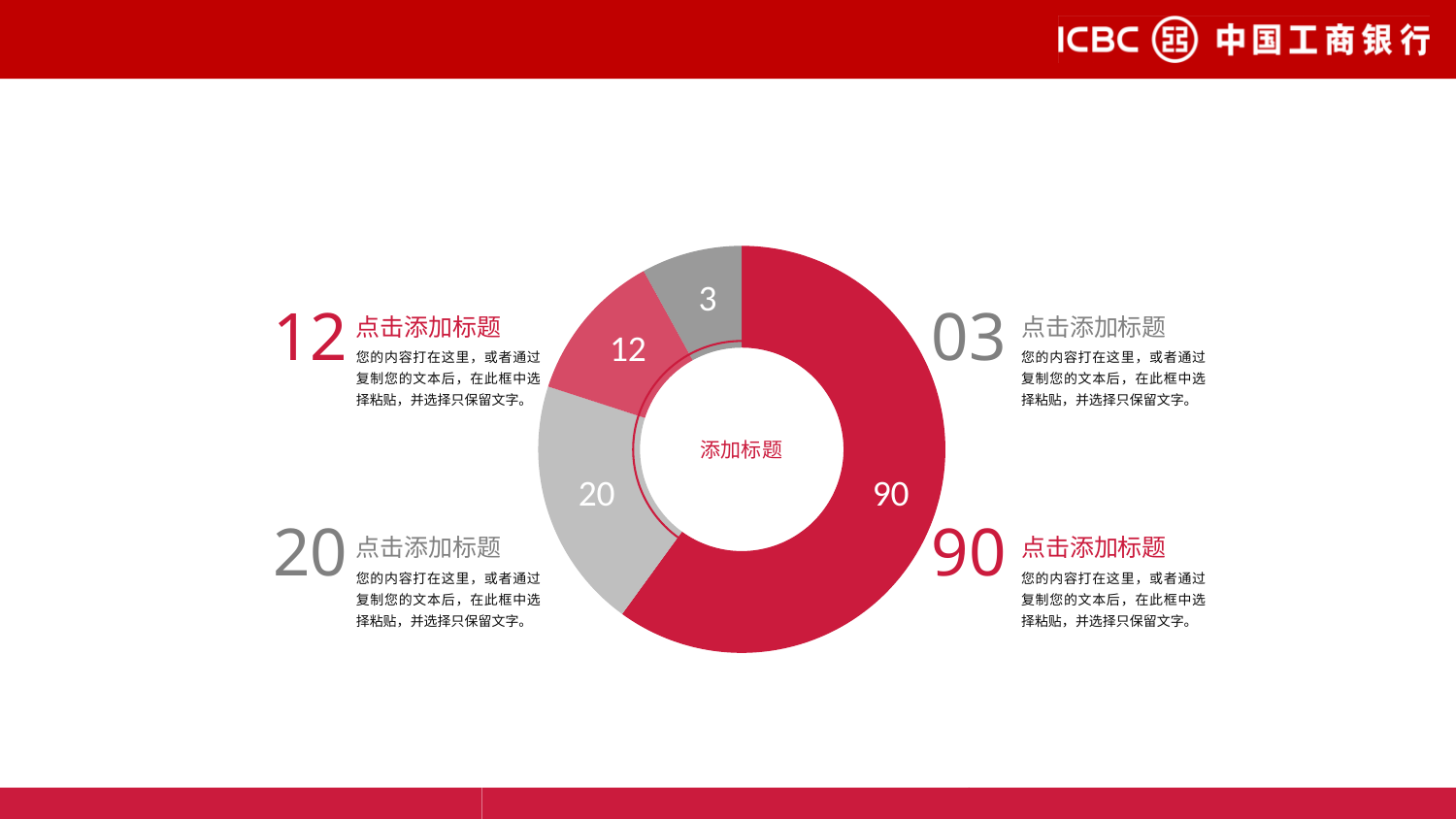
What is the value of the largest slice in the donut chart? 90 What text is written in the centre of the donut chart? 添加标题 What kind of chart is shown on the slide? pie chart (donut) What value is shown on the pink slice at the upper left of the donut chart? 12 What is the difference between the largest slice (90) and the light gray slice (20)? 70 What is the difference between the slice labelled 12 and the slice labelled 3? 9 What value is shown on the light gray slice at the left of the donut chart? 20 What is the value of the smallest slice in the donut chart? 3 How many slices does the donut chart have? 4 Which is larger, the light gray slice or the pink slice? the light gray slice (20)